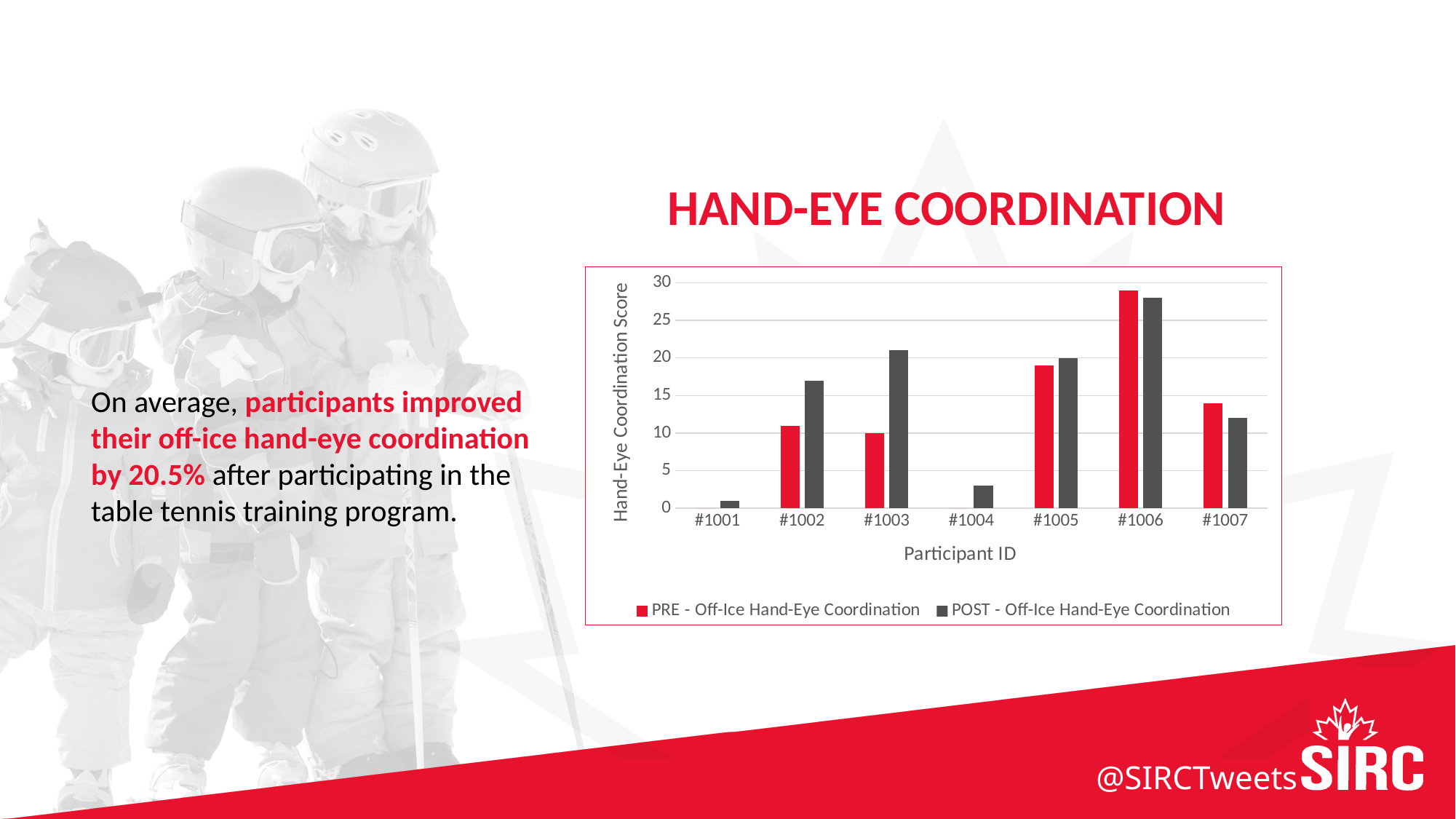
For participant #1007, is the PRE or the POST Off-Ice Hand-Eye Coordination score larger? PRE How many series does the chart's legend list? 2 Which participant has the highest POST - Off-Ice Hand-Eye Coordination score? #1006 What type of chart is shown on the slide? bar chart How many participant IDs are shown on the x axis of the chart? 7 Is the PRE - Off-Ice Hand-Eye Coordination score for participant #1006 greater or less than 25? greater Is the POST - Off-Ice Hand-Eye Coordination score for participant #1004 greater or less than 5? less What is the title of the chart? HAND-EYE COORDINATION Which colour represents the POST - Off-Ice Hand-Eye Coordination series? dark grey Which participant has the highest PRE - Off-Ice Hand-Eye Coordination score? #1006 For participant #1003, is the PRE or the POST Off-Ice Hand-Eye Coordination score larger? POST Which participant has the lowest POST - Off-Ice Hand-Eye Coordination score? #1001